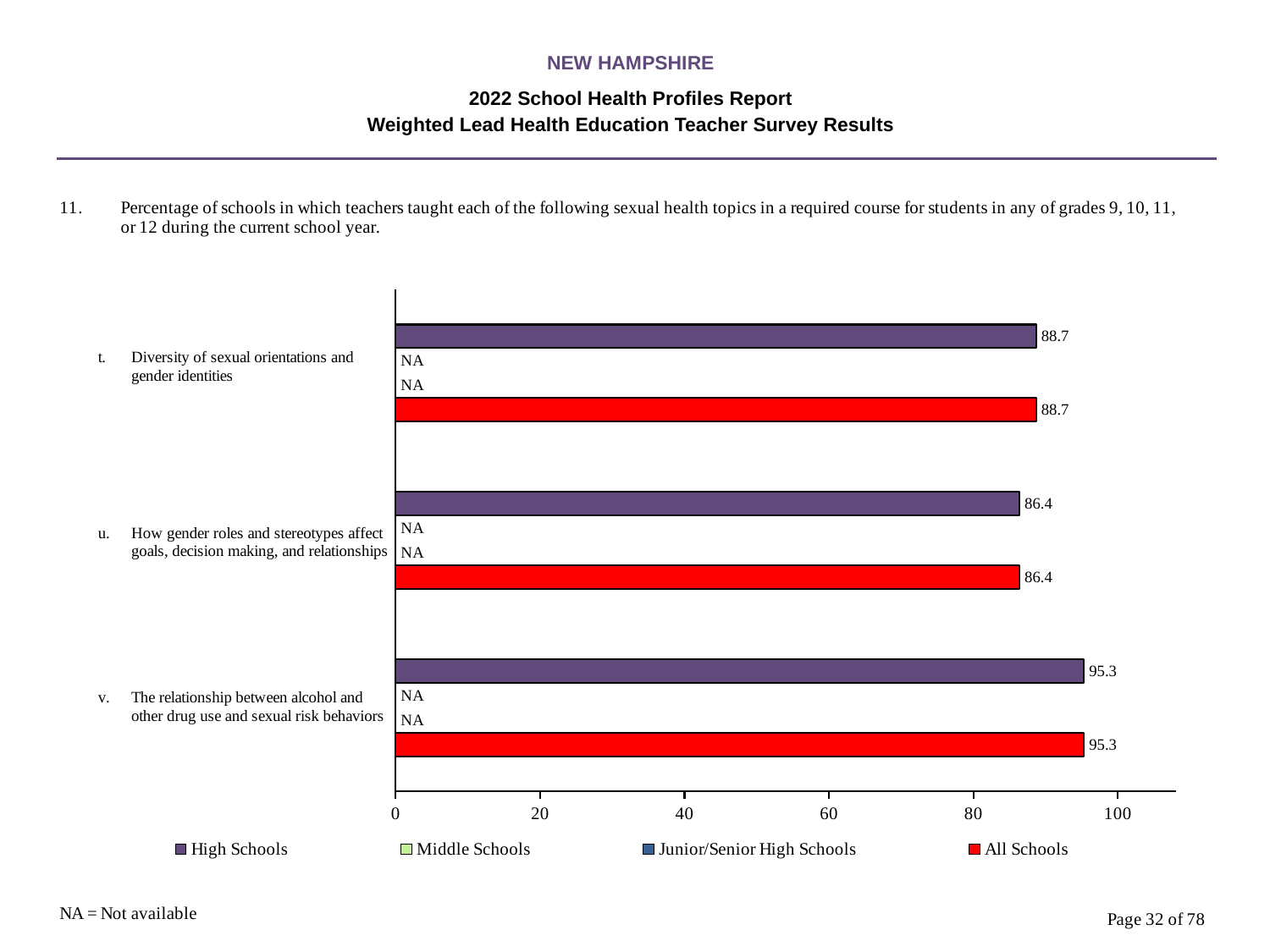
What is the All Schools value for topic t, diversity of sexual orientations and gender identities? 88.7 What is the High Schools value for topic v, the relationship between alcohol and other drug use and sexual risk behaviors? 95.3 Which topic has the highest High Schools value? v. The relationship between alcohol and other drug use and sexual risk behaviors What value is shown for Middle Schools for topic t? NA What is the High Schools value for topic u, how gender roles and stereotypes affect goals, decision making, and relationships? 86.4 What is the difference between the High Schools values for topic v and topic u? 8.9 Which topic has the lowest All Schools value? u. How gender roles and stereotypes affect goals, decision making, and relationships Which is larger, the High Schools value for topic t or for topic u? topic t How many series does the legend list? 4 How many topics are shown on the chart? 3 What kind of chart is shown? bar chart Is the All Schools value for topic v greater or less than 80? greater